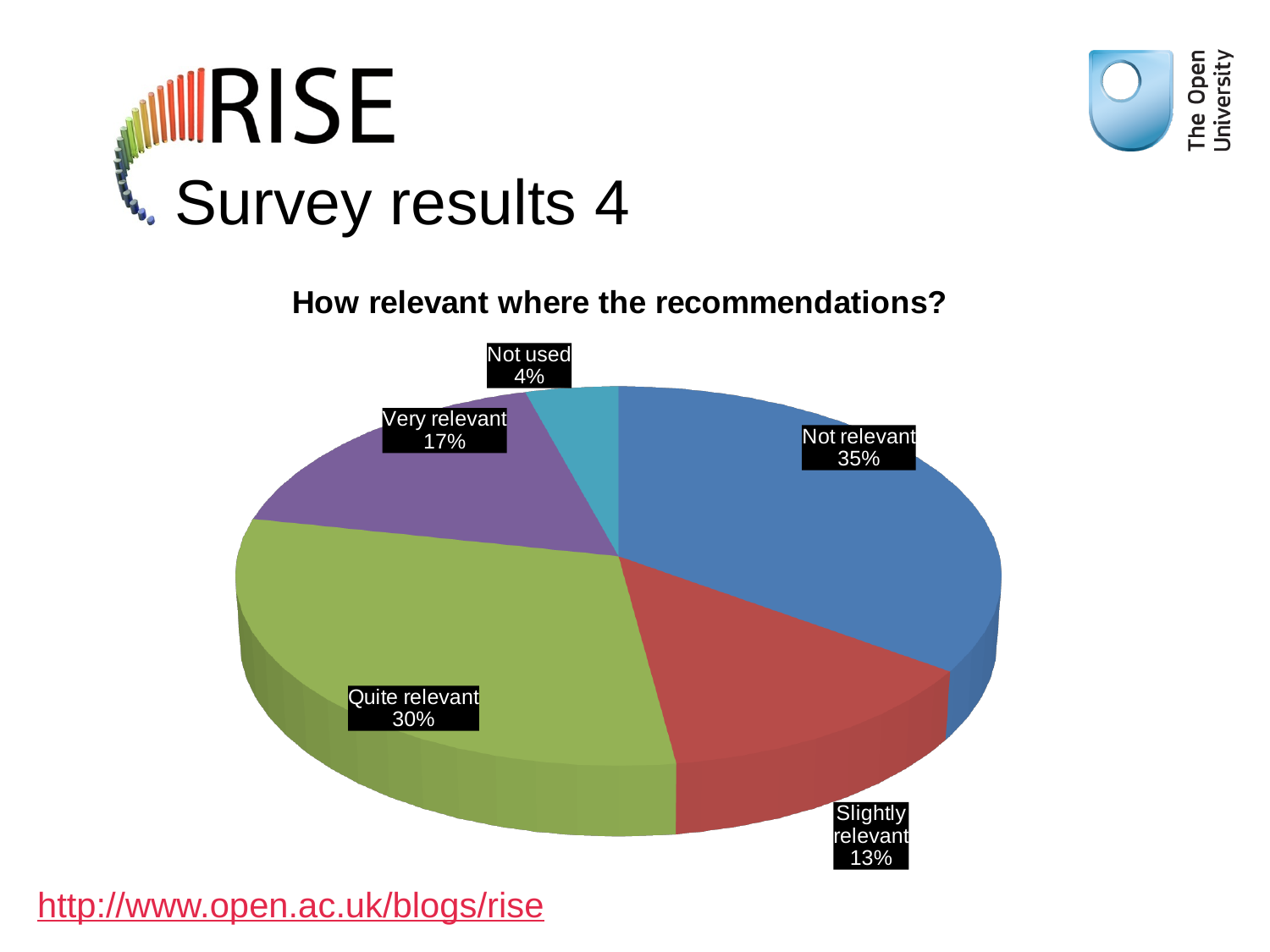
What is the title of the chart? How relevant where the recommendations? What share of the pie is 'Not relevant'? 35% Which is larger, 'Very relevant' or 'Slightly relevant'? Very relevant What share of the pie is 'Very relevant'? 17% Which category has the smallest share of the pie? Not used What share of the pie is 'Not used'? 4% What is the difference in percentage points between 'Not relevant' and 'Quite relevant'? 5 How many slices does the pie chart have? 5 Which category has the largest share of the pie? Not relevant What kind of chart is shown on the slide? Pie chart